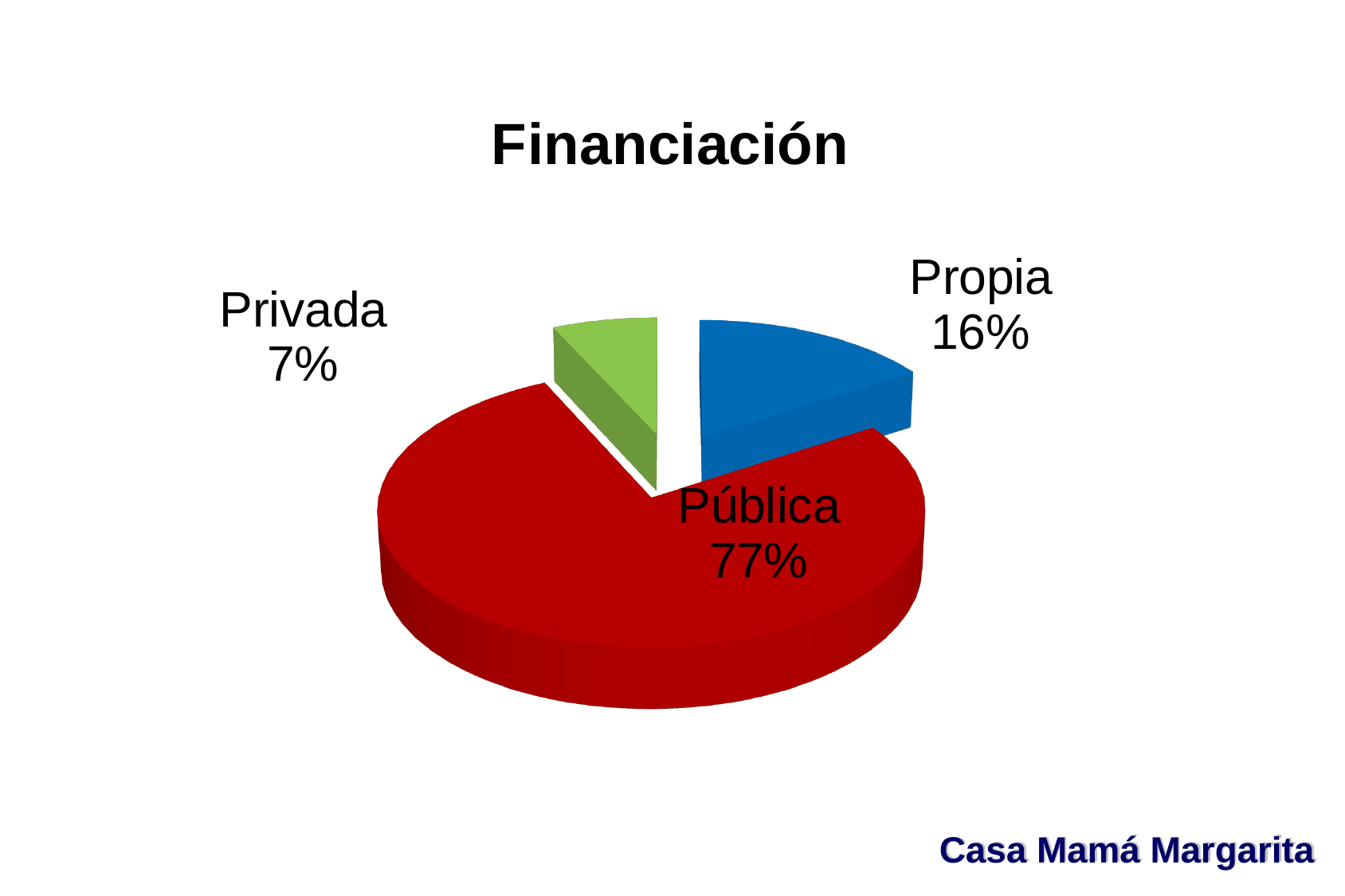
What is the value shown for Propia? 16% What share of the pie does Pública represent? 77% Which category has the largest slice of the pie? Pública What colour is the Pública slice? Red How many categories are shown in the pie chart? 3 Which category has the smallest slice of the pie? Privada What is the title of the chart? Financiación What is the difference between the Propia and Privada shares? 9% Which is larger, Propia or Privada? Propia What kind of chart is shown on the slide? Pie chart What is the difference between the Pública and Propia shares? 61% What is the value shown for Privada? 7%